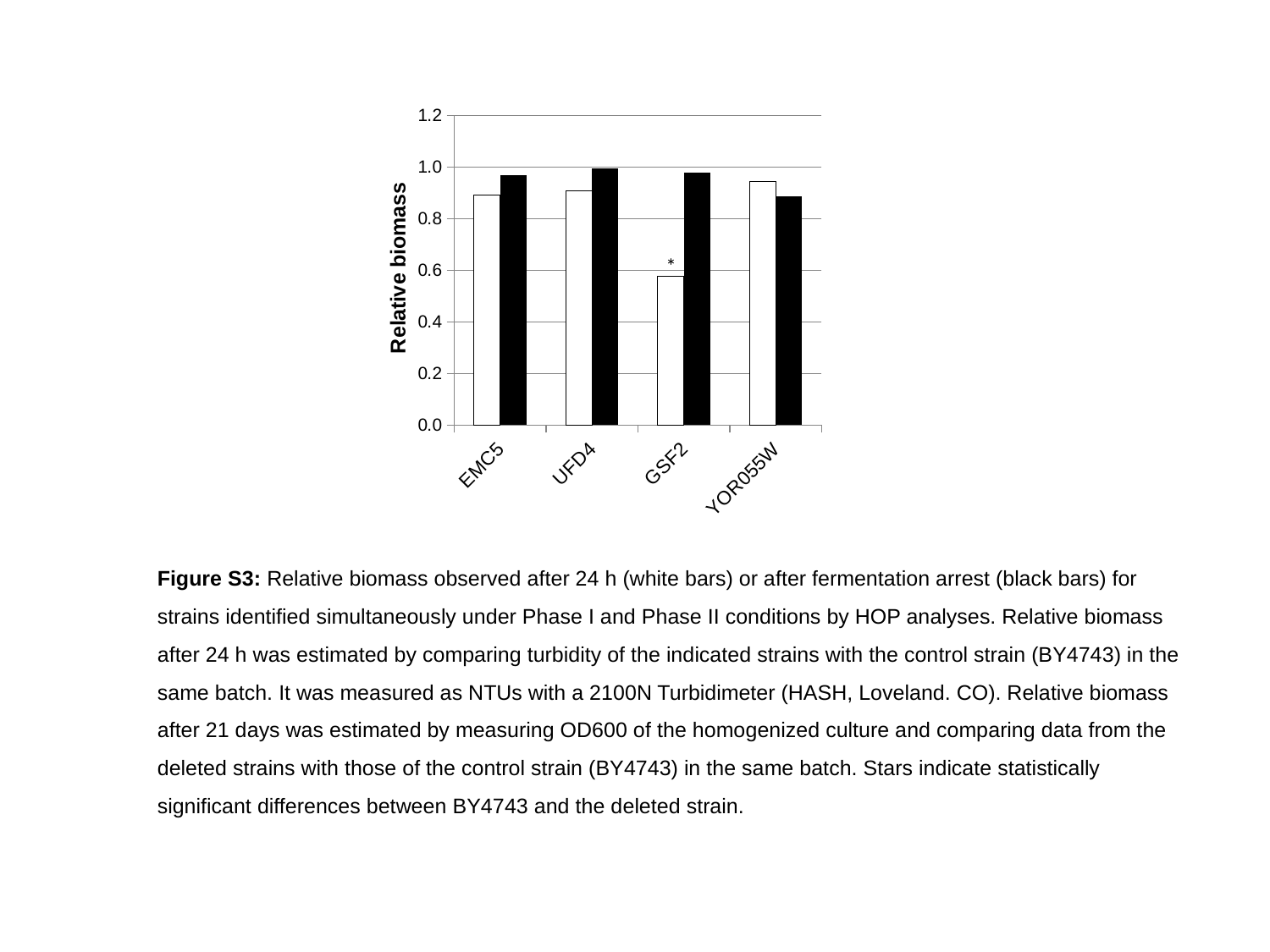
For YOR055W, which bar is taller, the white bar or the black bar? white bar How many bars are plotted for each strain in the chart? 2 Is the white bar for EMC5 greater or less than 0.8? greater Is the black bar for UFD4 greater or less than 0.8? greater Which strain's bar is marked with a star in the chart? GSF2 Is the white bar for GSF2 greater or less than 0.8? less What is the label of the y axis of the chart? Relative biomass Which strain has the lowest white bar (relative biomass after 24 h)? GSF2 What kind of chart is shown on the slide? bar chart For GSF2, which bar is taller, the white bar or the black bar? black bar How many strains (categories) are shown on the x axis of the chart? 4